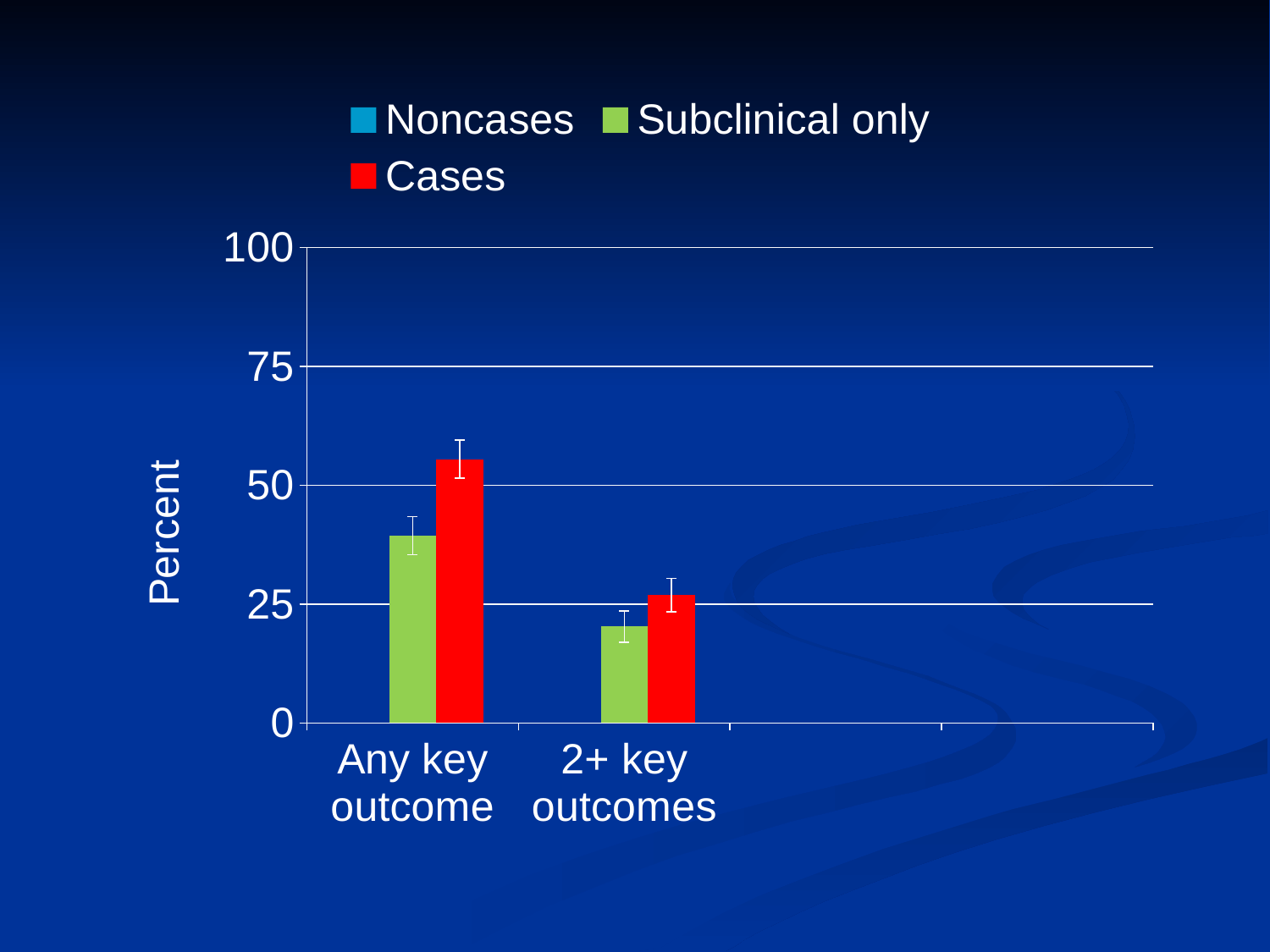
Is the value for Subclinical only in the Any key outcome category greater or less than 25? greater What kind of chart is shown on the slide? bar chart Is the value for Cases in the Any key outcome category greater or less than 50? greater What is the label on the y axis? Percent In the Any key outcome category, which is larger: Cases or Subclinical only? Cases Which bar is the tallest in the chart? Cases, Any key outcome Do the values for Cases rise or fall from Any key outcome to 2+ key outcomes? fall Is the value for Subclinical only in the 2+ key outcomes category greater or less than 25? less How many categories are shown on the x axis? 2 In the 2+ key outcomes category, which is larger: Cases or Subclinical only? Cases How many series does the legend list? 3